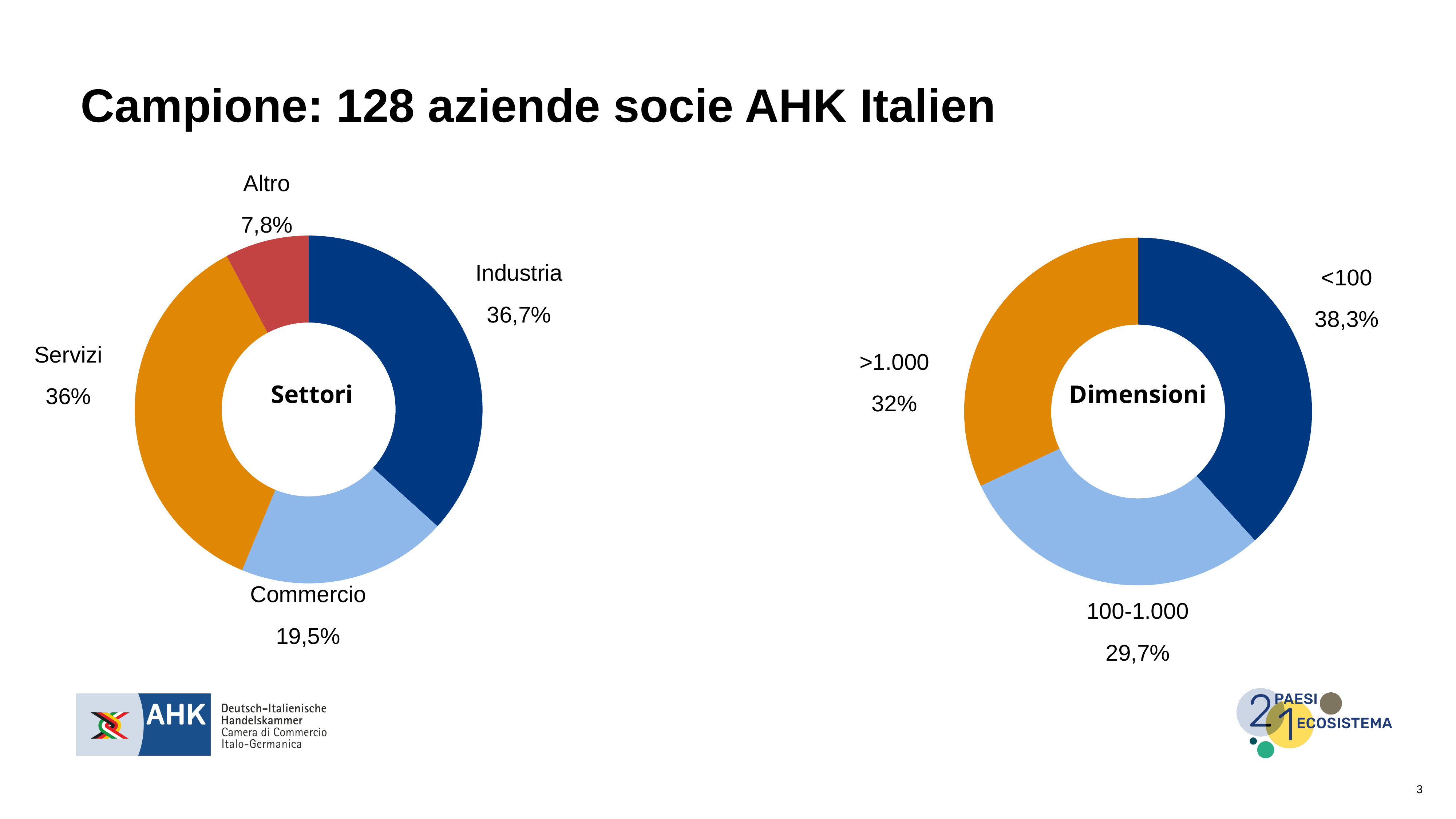
How many categories does the Dimensioni chart show? 3 In the Settori chart, what is the share for Industria? 36,7% In the Settori chart, which is larger, Commercio or Altro? Commercio In the Settori chart, what is the share for Commercio? 19,5% What kind of chart is the Settori chart? Doughnut chart In the Dimensioni chart, which category has the largest share? <100 How many categories does the Settori chart show? 4 In the Settori chart, what is the difference between the shares of Servizi and Altro? 28,2% In the Dimensioni chart, what colour is the >1.000 slice? Orange In the Dimensioni chart, what is the share for 100-1.000? 29,7% In the Settori chart, which category has the smallest share? Altro In the Dimensioni chart, what is the difference between the shares of <100 and >1.000? 6,3%